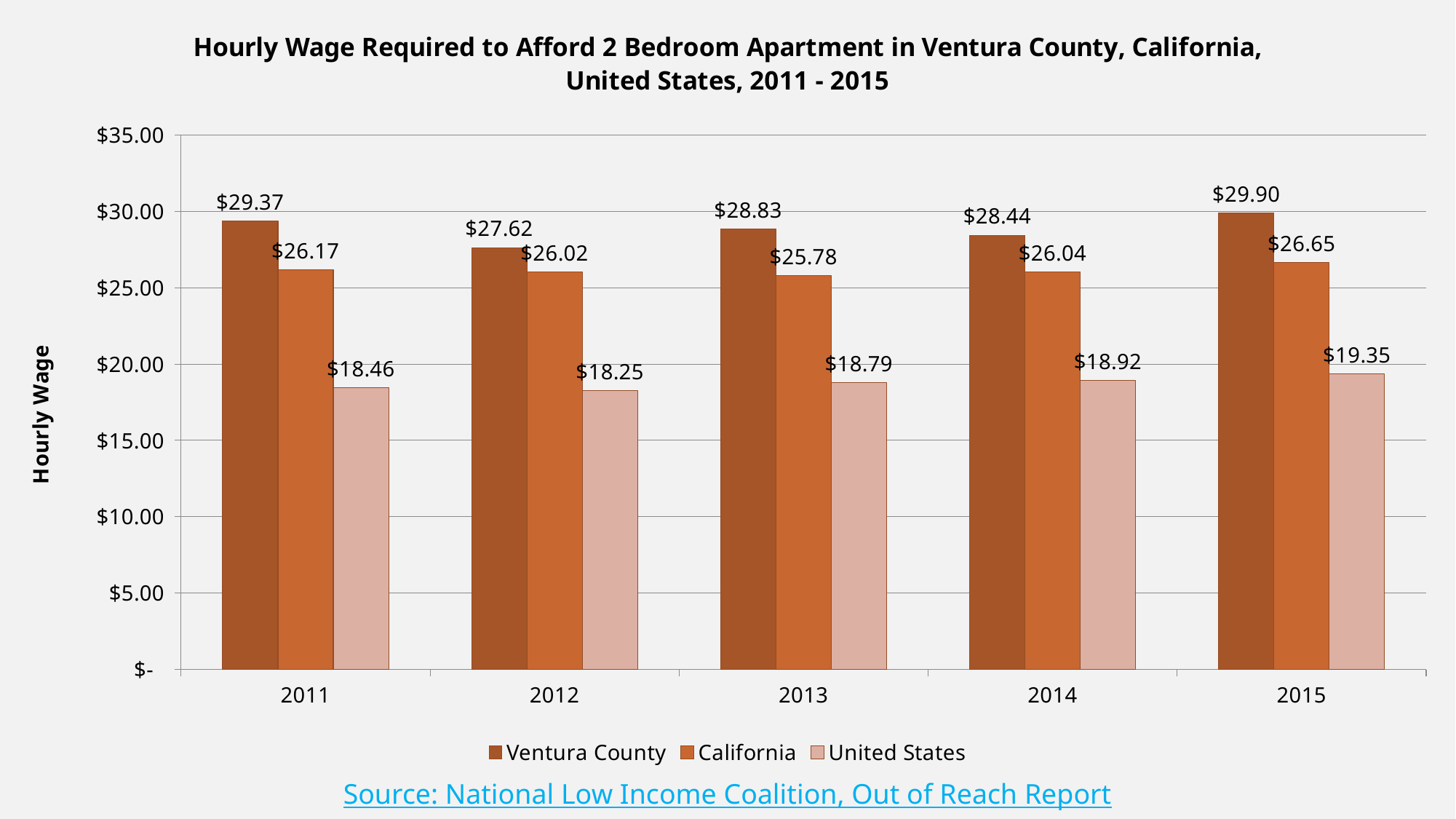
What is the difference between the Ventura County and United States hourly wages in 2014? $9.52 Is the value for California in 2015 greater or less than $25.00? greater What kind of chart is shown on the slide? Bar chart How many series does the legend list? 3 What is the hourly wage required for the United States in 2015? $19.35 In which year is the Ventura County hourly wage the highest? 2015 What is the hourly wage required for California in 2013? $25.78 What is the label on the vertical axis? Hourly Wage In which year is the United States hourly wage the lowest? 2012 How many years are shown on the x axis? 5 What is the hourly wage required for Ventura County in 2011? $29.37 Which is larger in 2012: the Ventura County wage or the California wage? Ventura County